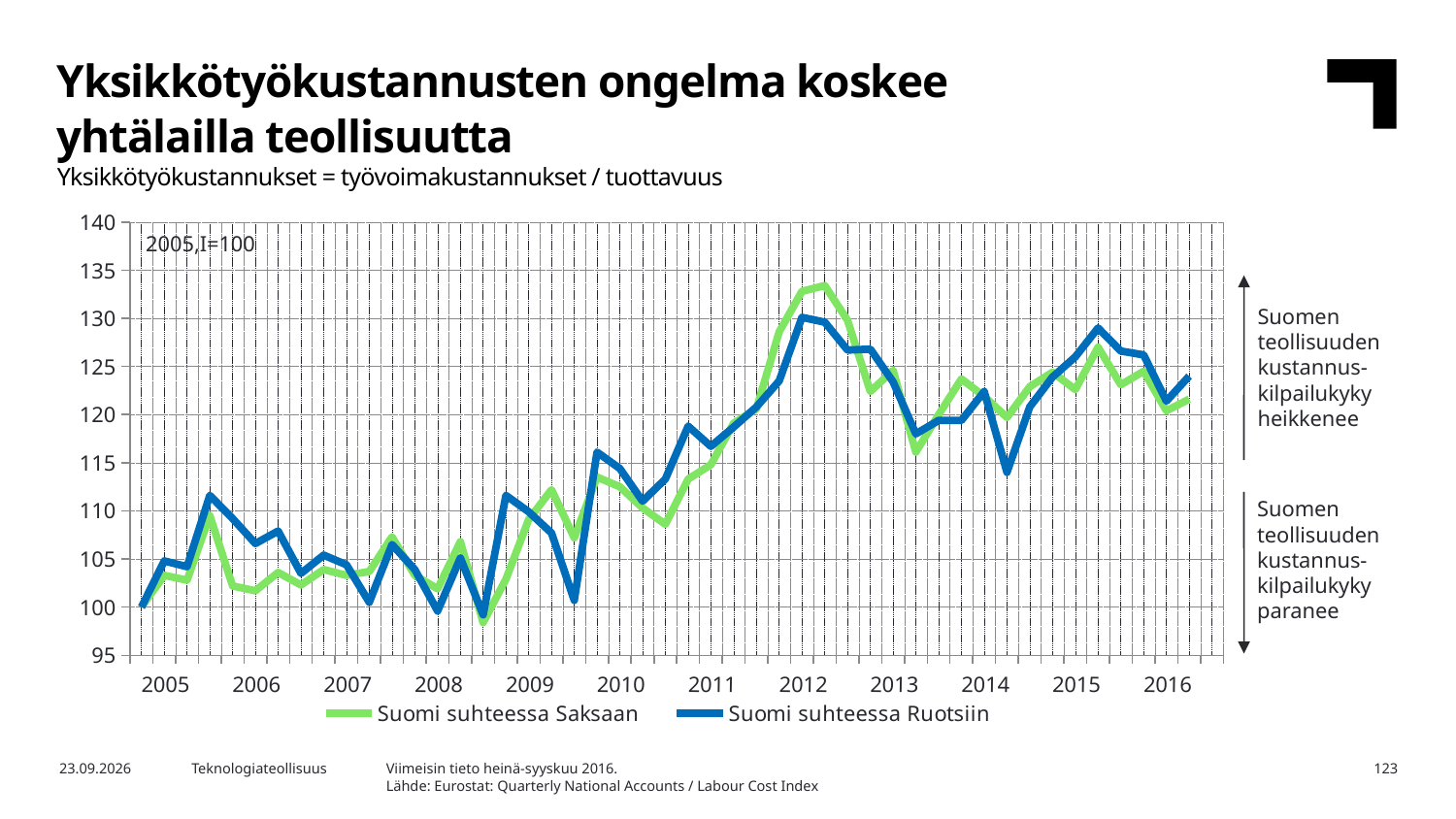
What is the index value of both series at the start of 2005? 100 What kind of chart is shown on the slide? line chart Is the peak value of Suomi suhteessa Ruotsiin in 2015 greater or less than 125? greater Which series is drawn in green? Suomi suhteessa Saksaan How many years are labelled on the x axis? 12 Which series reaches the highest value anywhere on the chart? Suomi suhteessa Saksaan How many series does the legend list? 2 Is the peak value of Suomi suhteessa Saksaan in 2012 greater or less than 130? greater Is the lowest value of Suomi suhteessa Ruotsiin in 2014 greater or less than 120? less What base period and value is the index set to, as noted on the chart? 2005,I=100 At the 2012 peak, which series is higher: Suomi suhteessa Saksaan or Suomi suhteessa Ruotsiin? Suomi suhteessa Saksaan Do the values of both series rise or fall between 2009 and 2012? rise